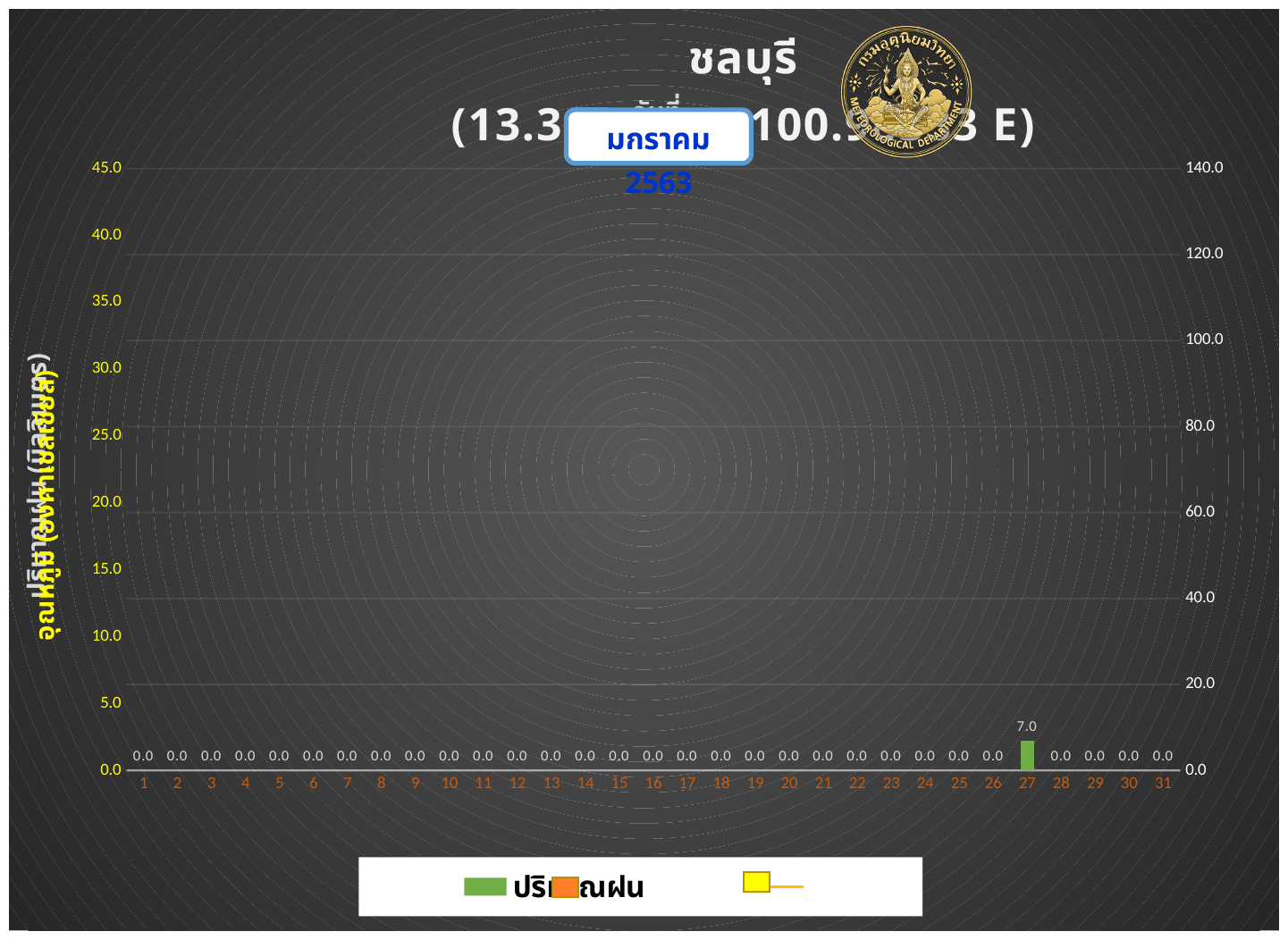
Which is larger, the value for day 27 or the value for day 31? day 27 How many days are shown on the x axis? 31 What is the value for day 15? 0.0 Is the value for day 27 greater or less than 10.0 on the left axis? less What is the difference between the values for day 27 and day 26? 7.0 What is the highest tick value on the left vertical axis? 45.0 What kind of chart is this? bar chart What is the highest tick value on the right vertical axis? 140.0 What is the value for day 27? 7.0 What is the value for day 1? 0.0 What is the value for day 31? 0.0 Which day has the highest value? 27